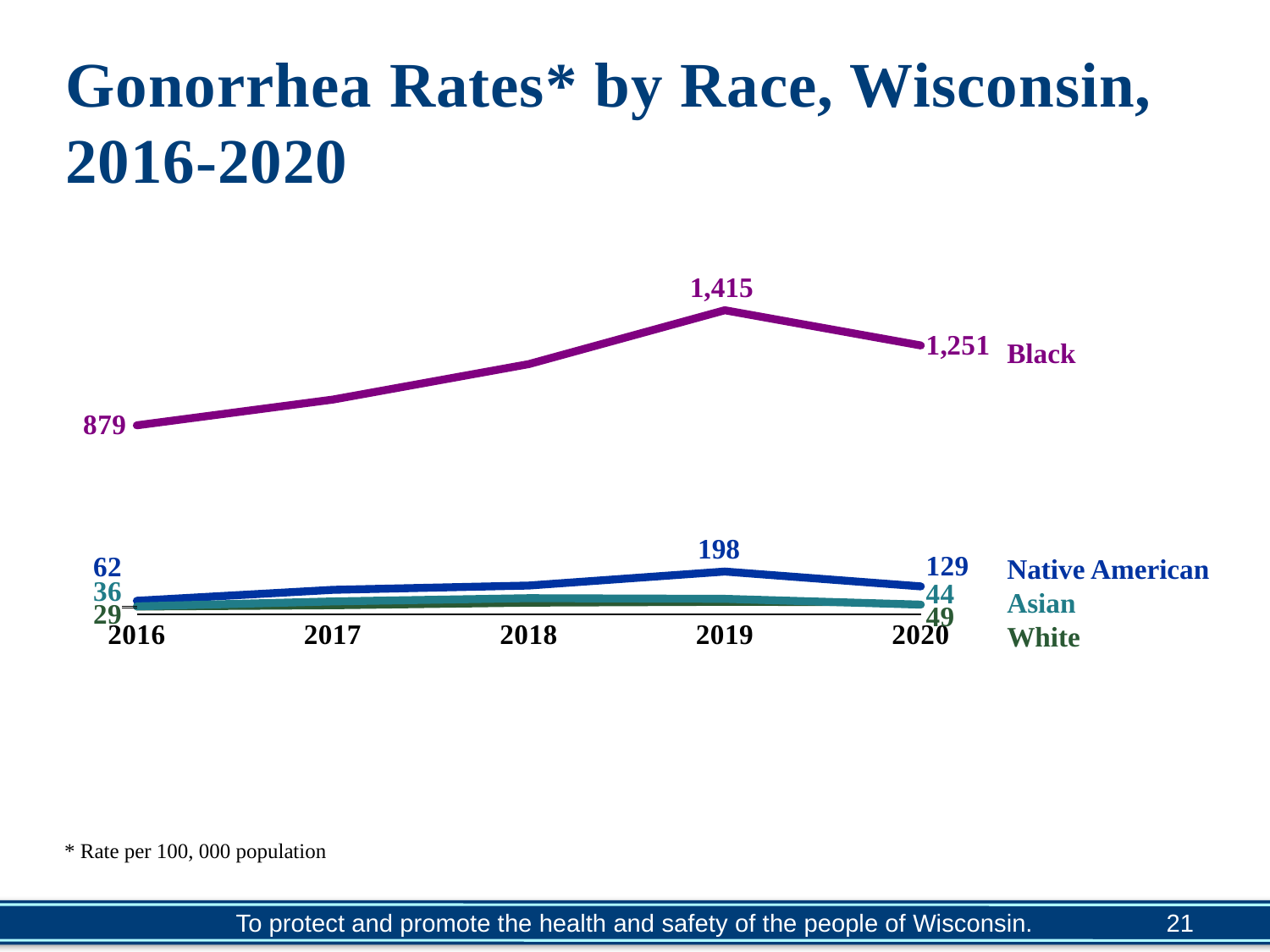
Which race has the lowest gonorrhea rate in 2016? White What kind of chart is shown on the slide? Line chart What is the gonorrhea rate for Asian residents in 2020? 44 Which is larger in 2020, the Asian rate or the White rate? White Which race has the highest gonorrhea rate in 2020? Black What is the gonorrhea rate for White residents in 2016? 29 What is the difference between the Black rate in 2019 and the Black rate in 2020? 164 What is the difference between the Native American rate in 2019 and in 2016? 136 What is the gonorrhea rate for Black residents in 2019? 1,415 How many race groups are plotted on the chart? 4 How many years are shown on the x axis? 5 What is the gonorrhea rate for Native American residents in 2020? 129